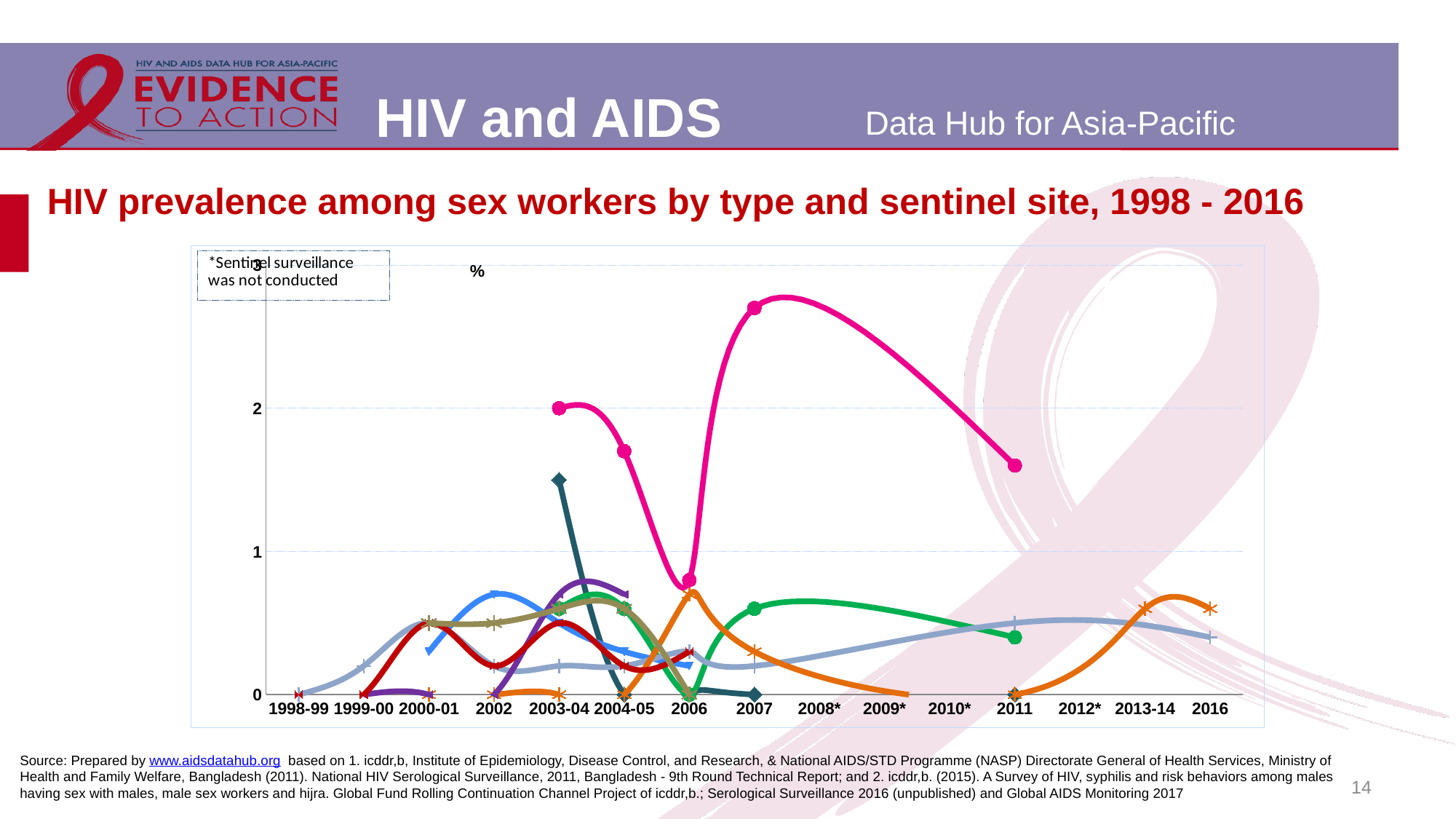
What kind of chart is shown on the slide? line chart Is the value of the dark teal line with diamond markers in 2003-04 greater or less than 1? greater Is the value of the pink line in 2006 greater or less than 1? less Does the pink line rise or fall between 2007 and 2011? fall Is the value of the pink line in 2011 greater or less than 1? greater Which is larger for the pink line: the value in 2003-04 or the value in 2006? 2003-04 How many time periods are labelled along the x axis of the chart? 15 In which period does the pink line reach its highest value? 2007 What is the value of the pink line in 2003-04? 2 What unit is shown on the y axis of the chart? % What is the title of the chart on the slide? HIV prevalence among sex workers by type and sentinel site, 1998 - 2016